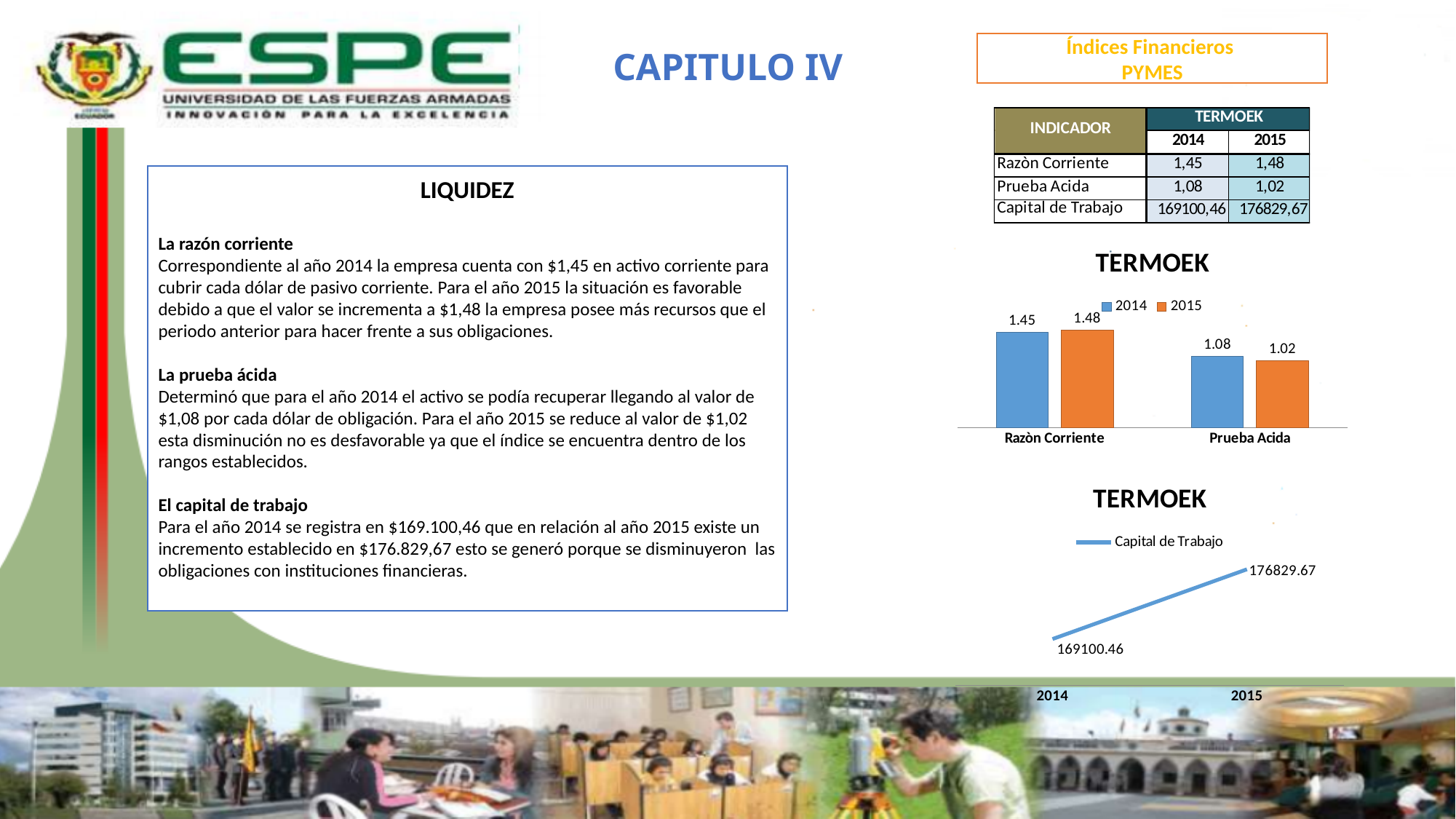
In the upper bar chart titled TERMOEK, what is the value for Prueba Acida in 2015? 1.02 In the upper bar chart titled TERMOEK, what is the value for Razòn Corriente in 2014? 1.45 In the lower line chart titled TERMOEK, what is the value of Capital de Trabajo for 2015? 176829.67 In the upper bar chart titled TERMOEK, what is the difference between the 2014 and 2015 values for Prueba Acida? 0.06 In the lower line chart titled TERMOEK, what is the difference between the 2015 and 2014 values of Capital de Trabajo? 7729.21 In the upper bar chart titled TERMOEK, how many series does the legend list? 2 What kind of chart is the upper TERMOEK chart? Bar chart In the upper bar chart titled TERMOEK, which is larger for Razòn Corriente: the 2014 value or the 2015 value? 2015 In the lower line chart titled TERMOEK, does Capital de Trabajo rise or fall from 2014 to 2015? Rise In the upper bar chart titled TERMOEK, what is the value for Razòn Corriente in 2015? 1.48 In the lower line chart titled TERMOEK, what is the value of Capital de Trabajo for 2014? 169100.46 In the upper bar chart titled TERMOEK, how many categories are shown on the x axis? 2